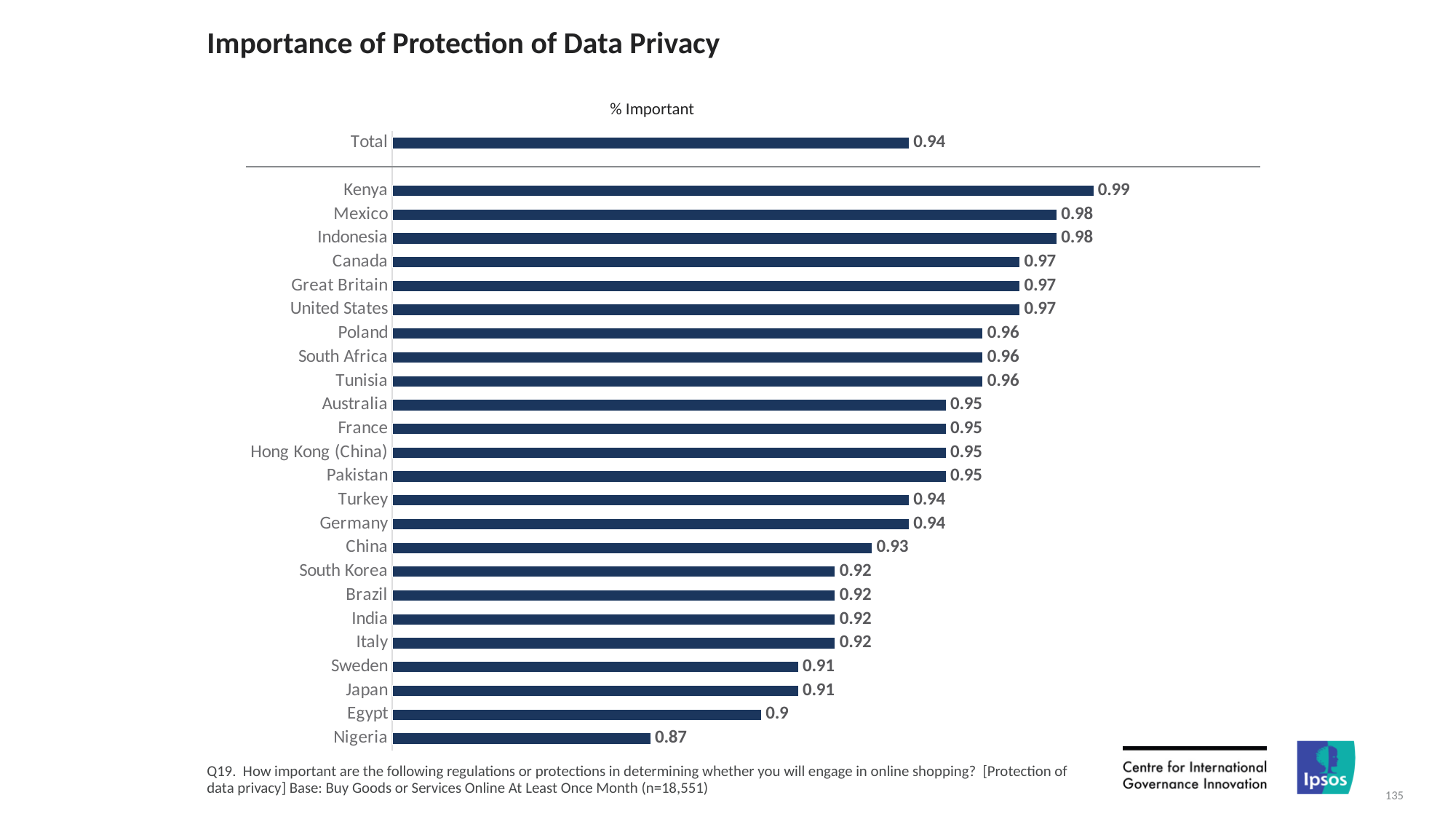
What is the value shown for Total? 0.94 Which country has the highest value? Kenya What is the difference between the values for Kenya and Nigeria? 0.12 What is the label shown above the chart? % Important What kind of chart is shown on the slide? Bar chart How many countries are listed below the Total bar? 24 Do the country values rise or fall going down the chart from Kenya to Nigeria? Fall Which country has the lowest value? Nigeria What is the value shown for Hong Kong (China)? 0.95 Which has the larger value, Canada or China? Canada What is the value shown for Nigeria? 0.87 What is the value shown for Egypt? 0.9